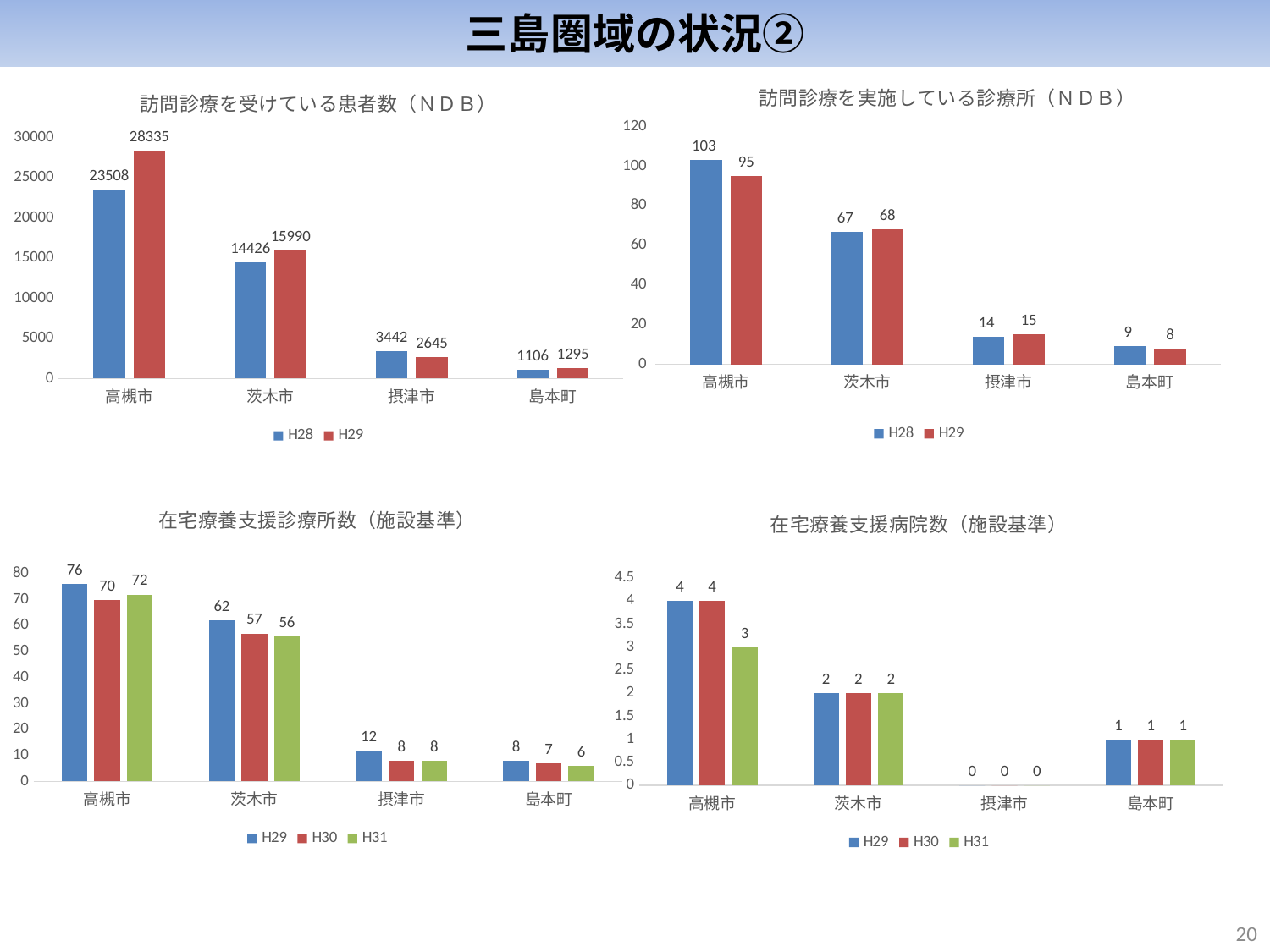
In the top-left chart 訪問診療を受けている患者数（ＮＤＢ）, which category has the lowest H28 value? 島本町 In the bottom-left chart 在宅療養支援診療所数（施設基準）, what is the difference between the H29 and H30 values for 摂津市? 4 What kind of chart is the bottom-right chart 在宅療養支援病院数（施設基準）? bar chart In the bottom-left chart 在宅療養支援診療所数（施設基準）, what is the H31 value for 茨木市? 56 In the bottom-right chart 在宅療養支援病院数（施設基準）, what is the H31 value for 高槻市? 3 In the top-left chart 訪問診療を受けている患者数（ＮＤＢ）, what is the difference between the H29 and H28 values for 茨木市? 1564 In the top-right chart 訪問診療を実施している診療所（ＮＤＢ）, how many series does the legend list? 2 In the bottom-right chart 在宅療養支援病院数（施設基準）, which category has the lowest values across all series? 摂津市 In the top-left chart 訪問診療を受けている患者数（ＮＤＢ）, what is the H29 value for 高槻市? 28335 In the bottom-left chart 在宅療養支援診療所数（施設基準）, how many categories are shown on the x axis? 4 In the top-right chart 訪問診療を実施している診療所（ＮＤＢ）, which is larger for 茨木市, the H28 value or the H29 value? H29 In the top-right chart 訪問診療を実施している診療所（ＮＤＢ）, what is the H28 value for 高槻市? 103